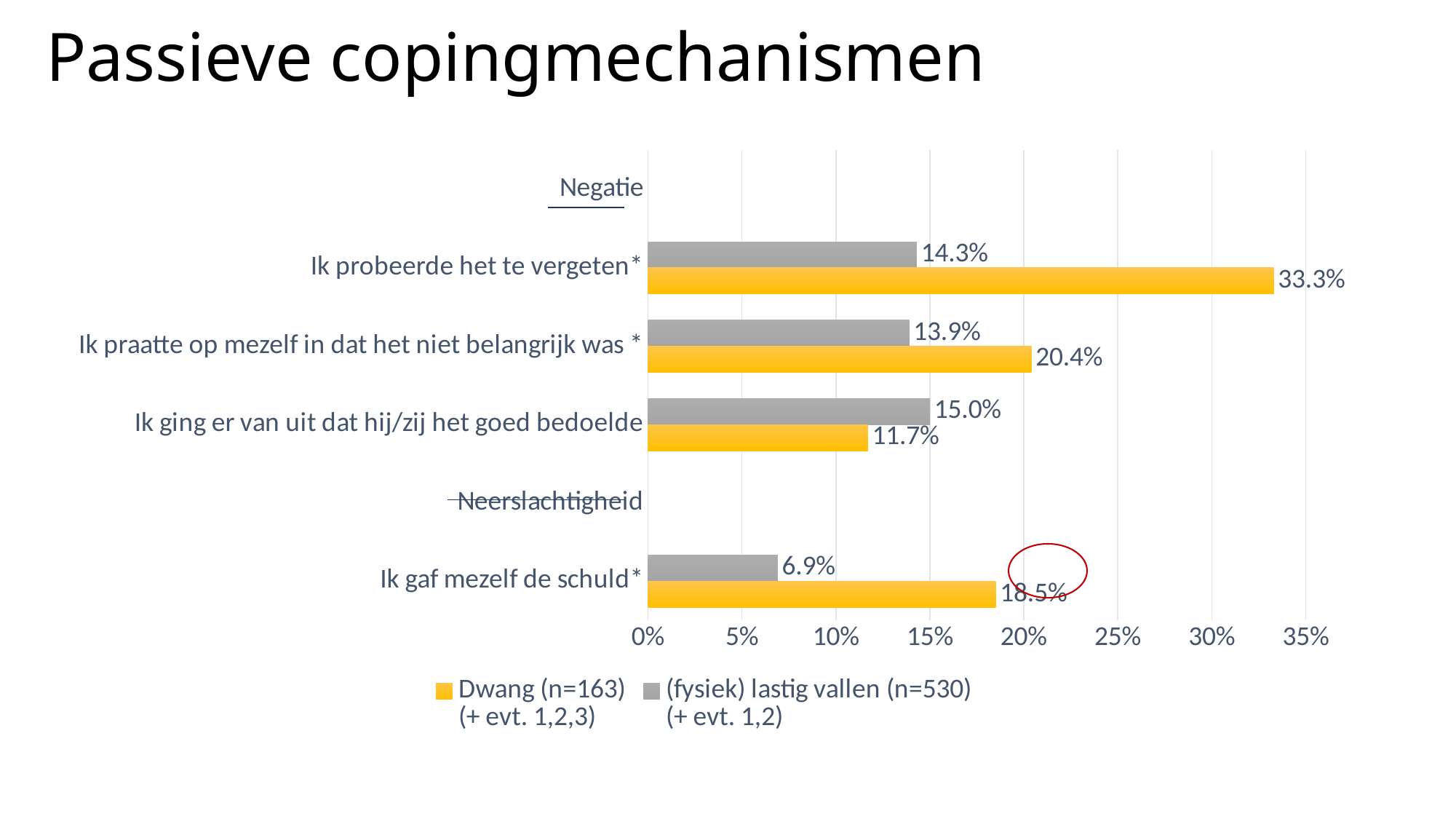
What is the value for 'Ik gaf mezelf de schuld' in the (fysiek) lastig vallen (n=530) series? 6.9% How many series does the legend list? 2 What is the value for 'Ik probeerde het te vergeten' in the (fysiek) lastig vallen (n=530) series? 14.3% Which category has the lowest value in the (fysiek) lastig vallen (n=530) series? Ik gaf mezelf de schuld Which colour represents the Dwang (n=163) series in the chart? Yellow For 'Ik ging er van uit dat hij/zij het goed bedoelde', which series has the larger value, Dwang (n=163) or (fysiek) lastig vallen (n=530)? (fysiek) lastig vallen (n=530) What is the value for 'Ik ging er van uit dat hij/zij het goed bedoelde' in the (fysiek) lastig vallen (n=530) series? 15.0% What is the difference between the Dwang and (fysiek) lastig vallen values for 'Ik probeerde het te vergeten'? 19.0% What is the value for 'Ik praatte op mezelf in dat het niet belangrijk was' in the Dwang (n=163) series? 20.4% What kind of chart is shown on the slide? Bar chart Which category has the highest value in the Dwang (n=163) series? Ik probeerde het te vergeten What is the value for 'Ik probeerde het te vergeten' in the Dwang (n=163) series? 33.3%